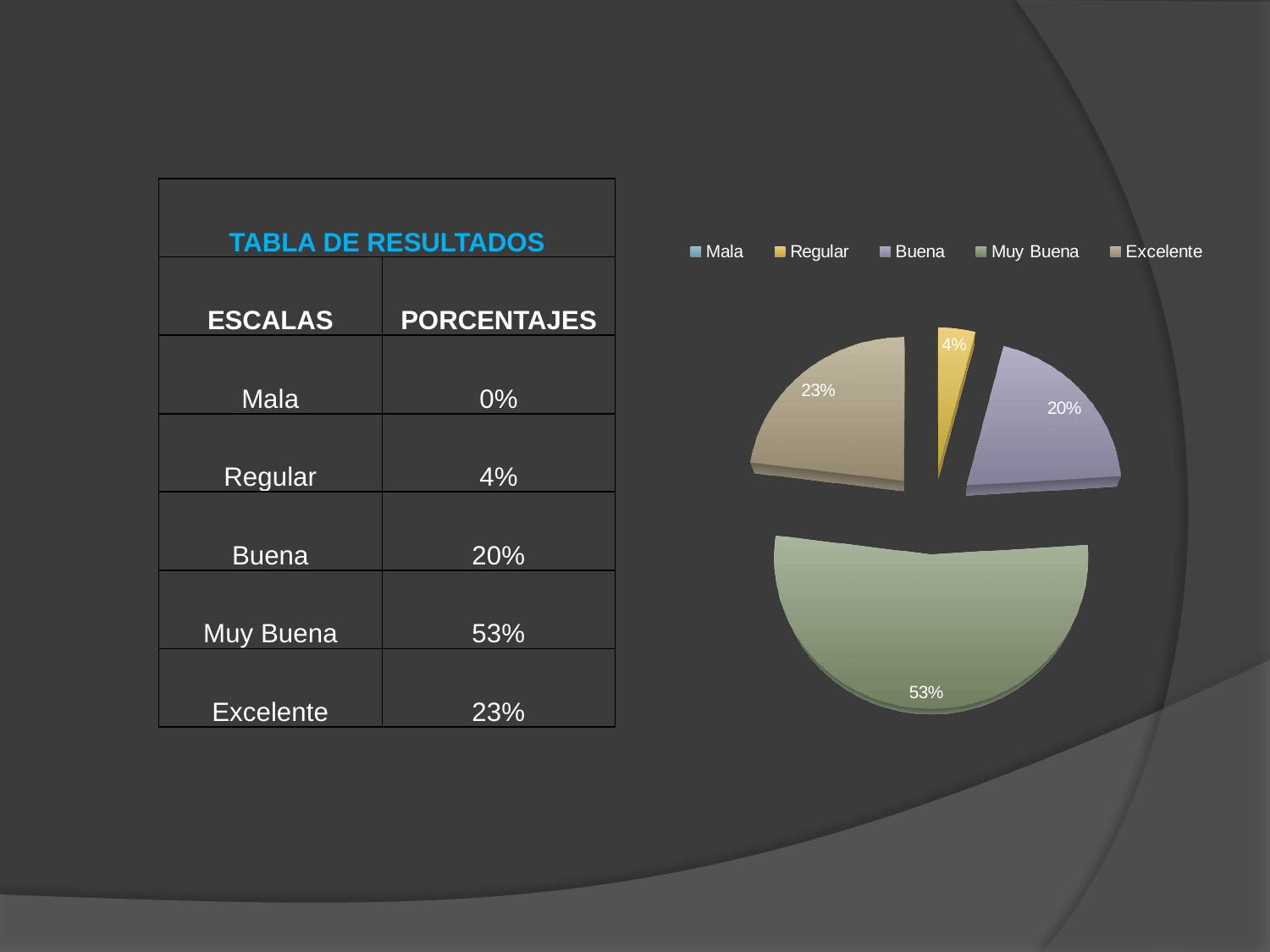
What percentage does the pie chart show for Regular? 4% What percentage does the pie chart show for Muy Buena? 53% What is the difference between the Muy Buena and Excelente percentages in the pie chart? 30% Which is larger in the pie chart, Buena or Excelente? Excelente Which category has the largest slice in the pie chart? Muy Buena What percentage does the pie chart show for Buena? 20% What is the difference between the Buena and Regular percentages in the pie chart? 16% What percentage does the pie chart show for Excelente? 23% Which legend entry in the pie chart is shown in yellow? Regular How many categories does the pie chart's legend list? 5 Which labelled slice in the pie chart is the smallest? Regular What kind of chart is shown on the slide? pie chart